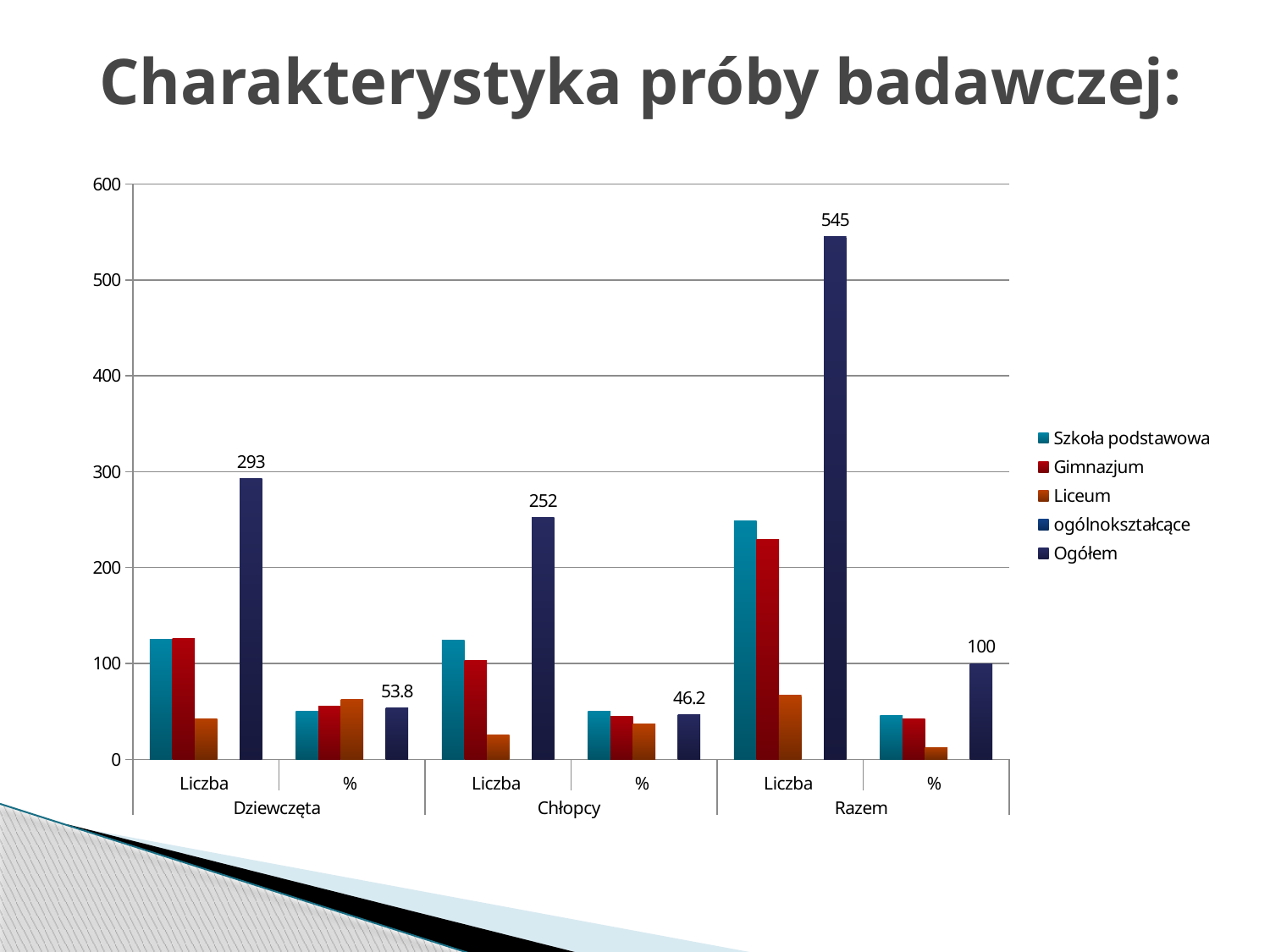
Which category has the highest Ogółem value? Liczba under Razem What is the value of the Ogółem bar for Liczba under Razem? 545 What is the value of the Ogółem bar for Liczba under Dziewczęta? 293 What kind of chart is shown on the slide? bar chart What is the value of the Ogółem bar for % under Dziewczęta? 53.8 What is the value of the Ogółem bar for % under Chłopcy? 46.2 How many entries does the legend list? 5 Which is larger, the Ogółem Liczba value for Dziewczęta or for Chłopcy? Dziewczęta What is the difference between the Ogółem % values for Dziewczęta and Chłopcy? 7.6 Is the Szkoła podstawowa value for Liczba under Razem greater or less than 200? greater What is the difference between the Ogółem Liczba values for Dziewczęta and Chłopcy? 41 Is the Liceum value for Liczba under Razem greater or less than 100? less